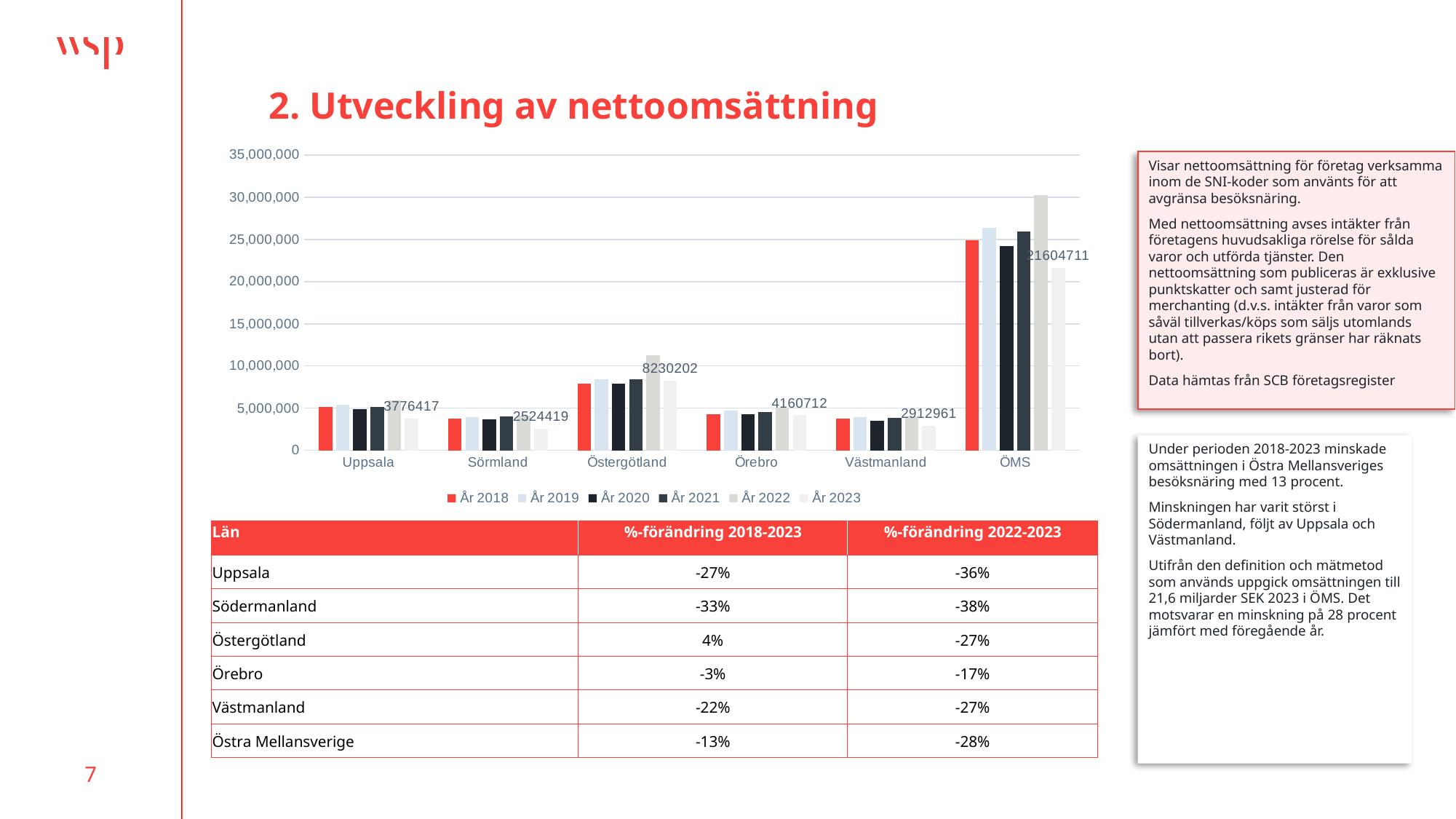
Which category has the lowest År 2023 value? Sörmland What is the År 2023 value for Uppsala? 3776417 Is the År 2022 value for Östergötland greater or less than 10,000,000? greater Which category has the highest År 2023 value? ÖMS How many categories are shown on the x axis of the chart? 6 What is the År 2023 value for Östergötland? 8230202 Which has the larger År 2023 value, Uppsala or Västmanland? Uppsala What kind of chart is shown on the slide? Bar chart How many series does the chart legend list? 6 What is the År 2023 value for ÖMS? 21604711 What is the difference between the År 2023 values for Östergötland and Örebro? 4069490 What is the År 2023 value for Sörmland? 2524419